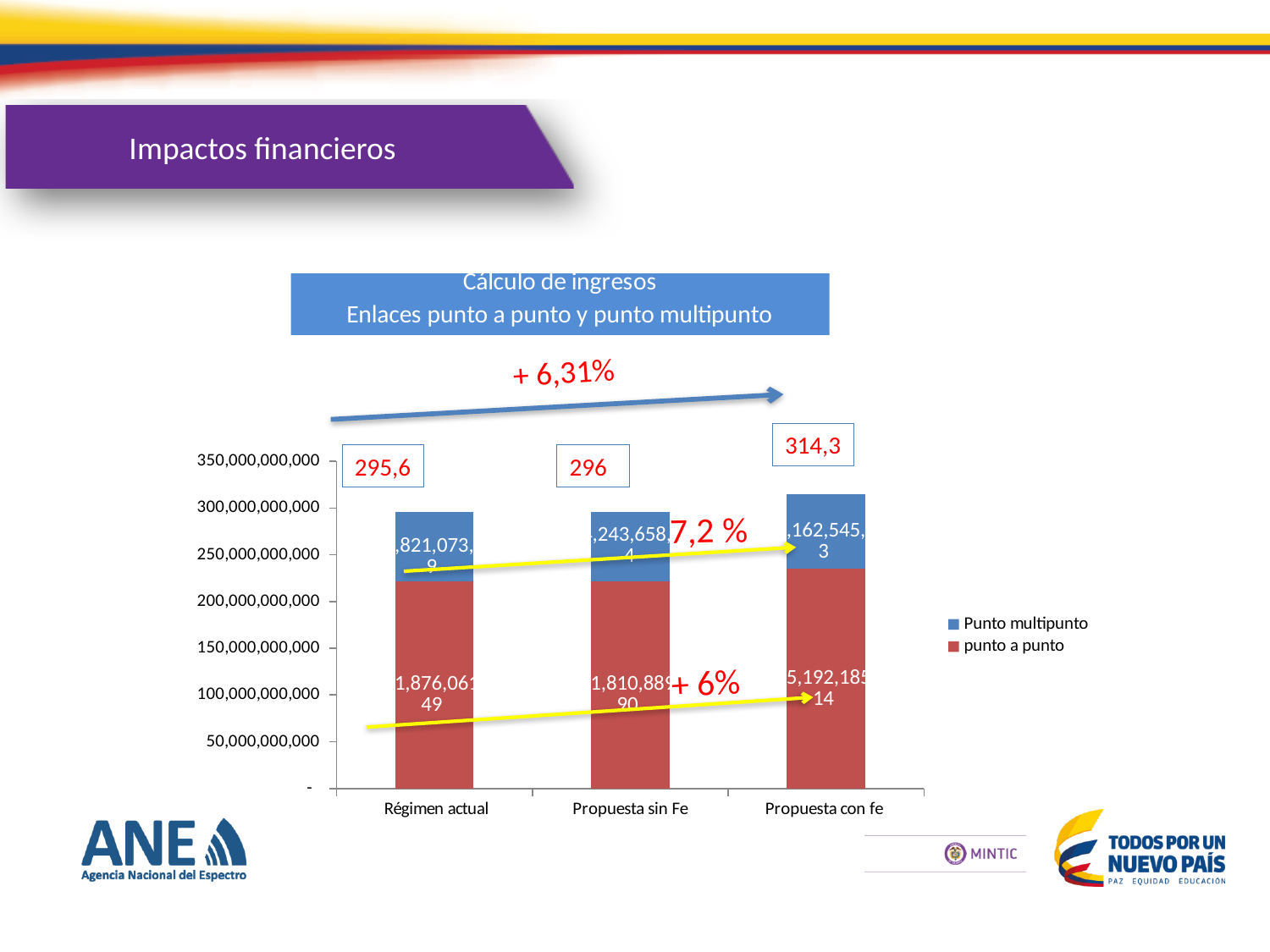
What is the title shown above the chart? Cálculo de ingresos Enlaces punto a punto y punto multipunto Is the total stacked bar for Régimen actual greater or less than 300,000,000,000? less How many series does the chart legend list? 2 Is the punto a punto value for Régimen actual greater or less than 200,000,000,000? greater Is the punto a punto value for Propuesta sin Fe greater or less than 250,000,000,000? less What kind of chart is shown on the slide? Stacked bar chart How many categories are shown on the x axis of the chart? 3 Which stacked bar is taller, Propuesta con fe or Régimen actual? Propuesta con fe Which category has the tallest stacked bar? Propuesta con fe What are the two series named in the chart legend? Punto multipunto and punto a punto What value is written in the box above the Propuesta con fe bar? 314,3